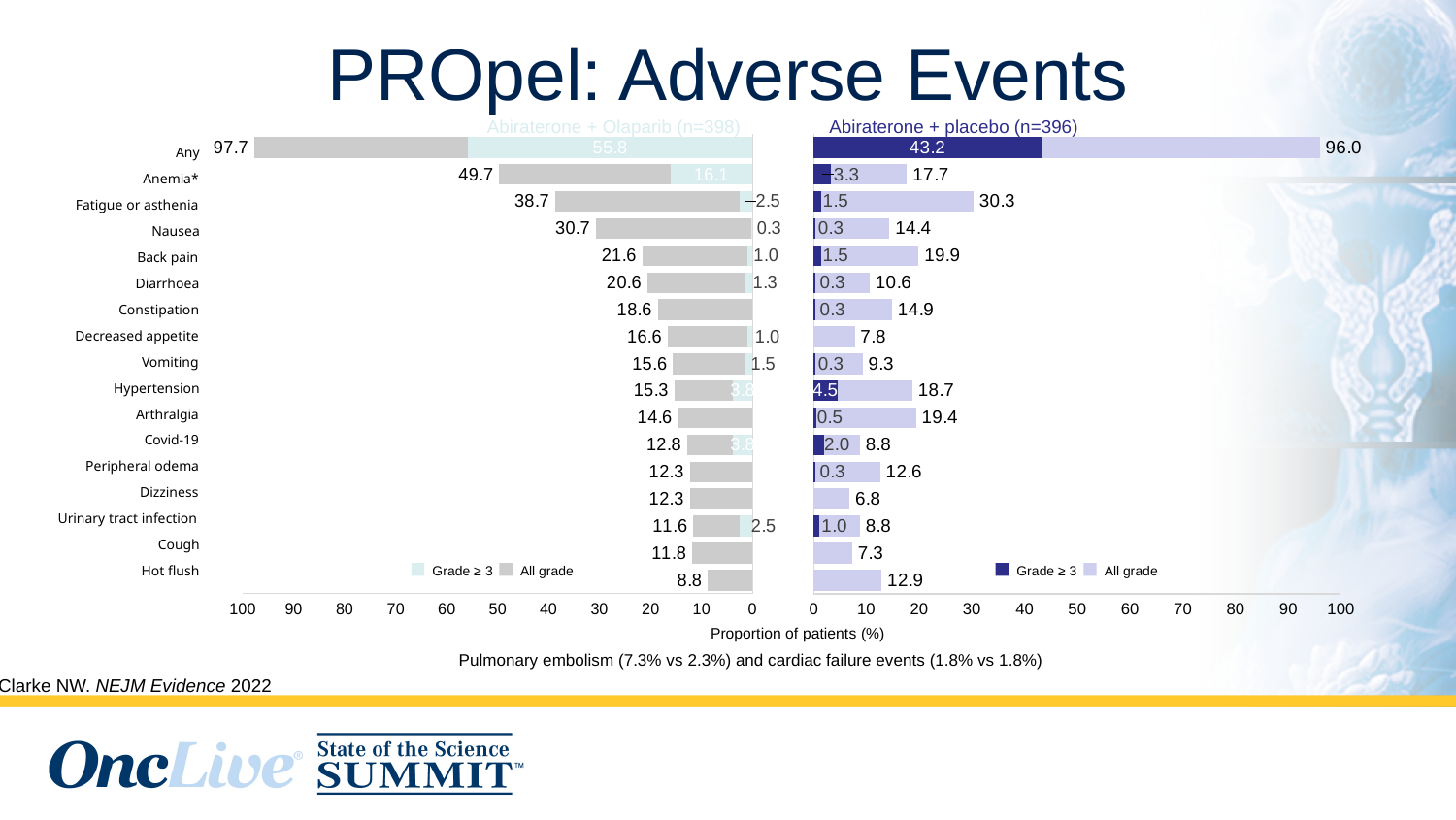
In the Abiraterone + Olaparib chart, what is the all-grade value for Anemia*? 49.7 What is the difference between the all-grade Anemia* values in the Abiraterone + Olaparib chart and the Abiraterone + placebo chart? 32.0 How many series does the legend of the Abiraterone + placebo chart list? 2 Is the all-grade value for Nausea larger in the Abiraterone + Olaparib chart or the Abiraterone + placebo chart? Abiraterone + Olaparib How many adverse event categories are listed on the y axis of the charts? 17 What type of chart is used for the Abiraterone + Olaparib data? Bar chart In the Abiraterone + placebo chart, is the all-grade value for Arthralgia greater or less than 10? greater In the Abiraterone + Olaparib chart, which adverse event category has the lowest all-grade value? Hot flush In the Abiraterone + placebo chart, what is the Grade ≥ 3 value for Any adverse event? 43.2 In the Abiraterone + placebo chart, which adverse event category has the highest all-grade value? Any In the Abiraterone + placebo chart, what is the all-grade value for Fatigue or asthenia? 30.3 What is the x-axis label shared by the two charts? Proportion of patients (%)